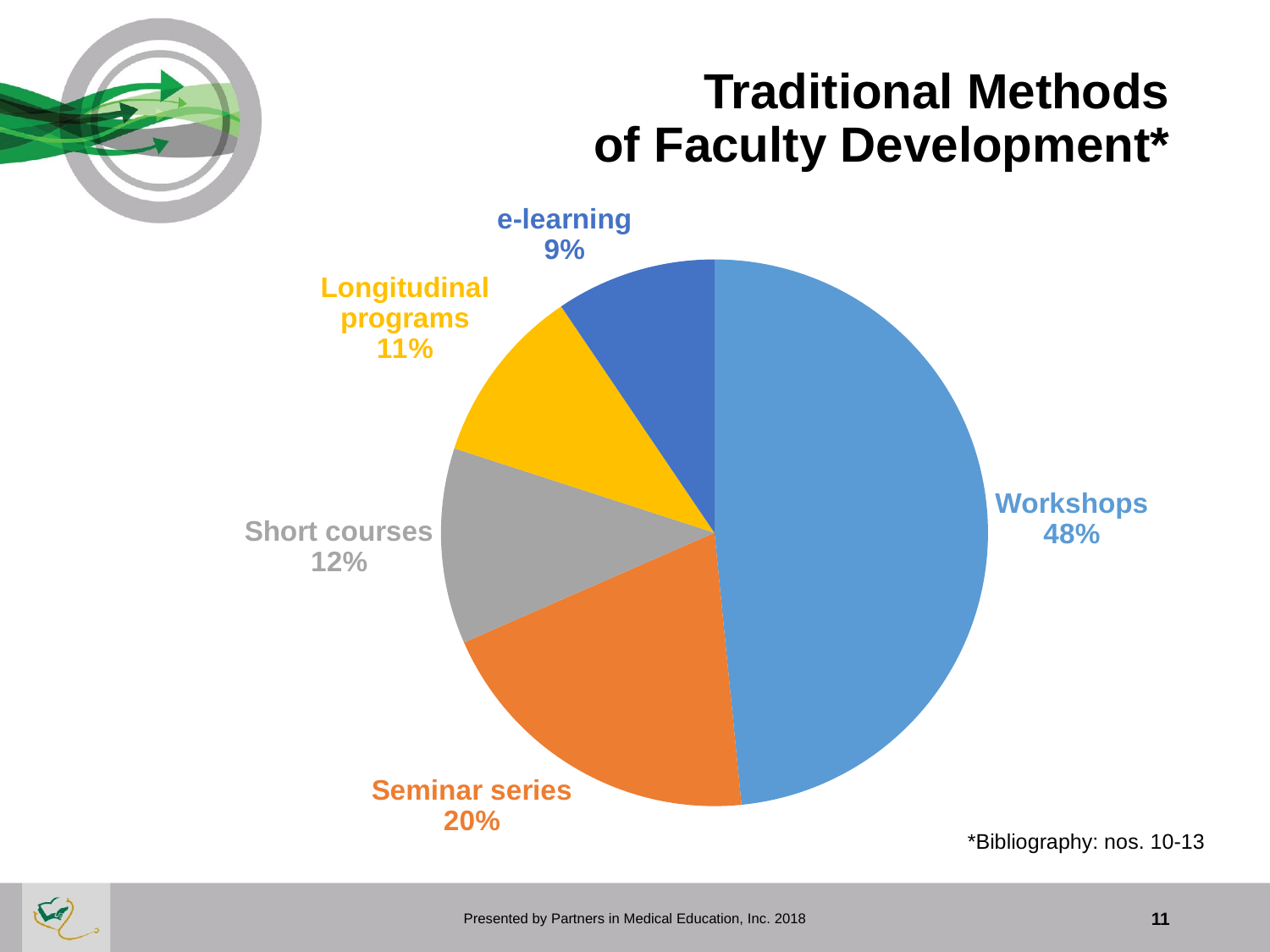
How many categories are shown in the pie chart? 5 What share of the pie is Workshops? 48% What is the value for e-learning? 9% What is the value for Seminar series? 20% What is the difference between the Workshops share and the Seminar series share? 28% What is the value for Short courses? 12% Which is larger, Short courses or Longitudinal programs? Short courses What is the title of the chart? Traditional Methods of Faculty Development* What is the value for Longitudinal programs? 11% Which category has the smallest share of the pie? e-learning Which category has the largest share of the pie? Workshops What kind of chart is shown on the slide? pie chart